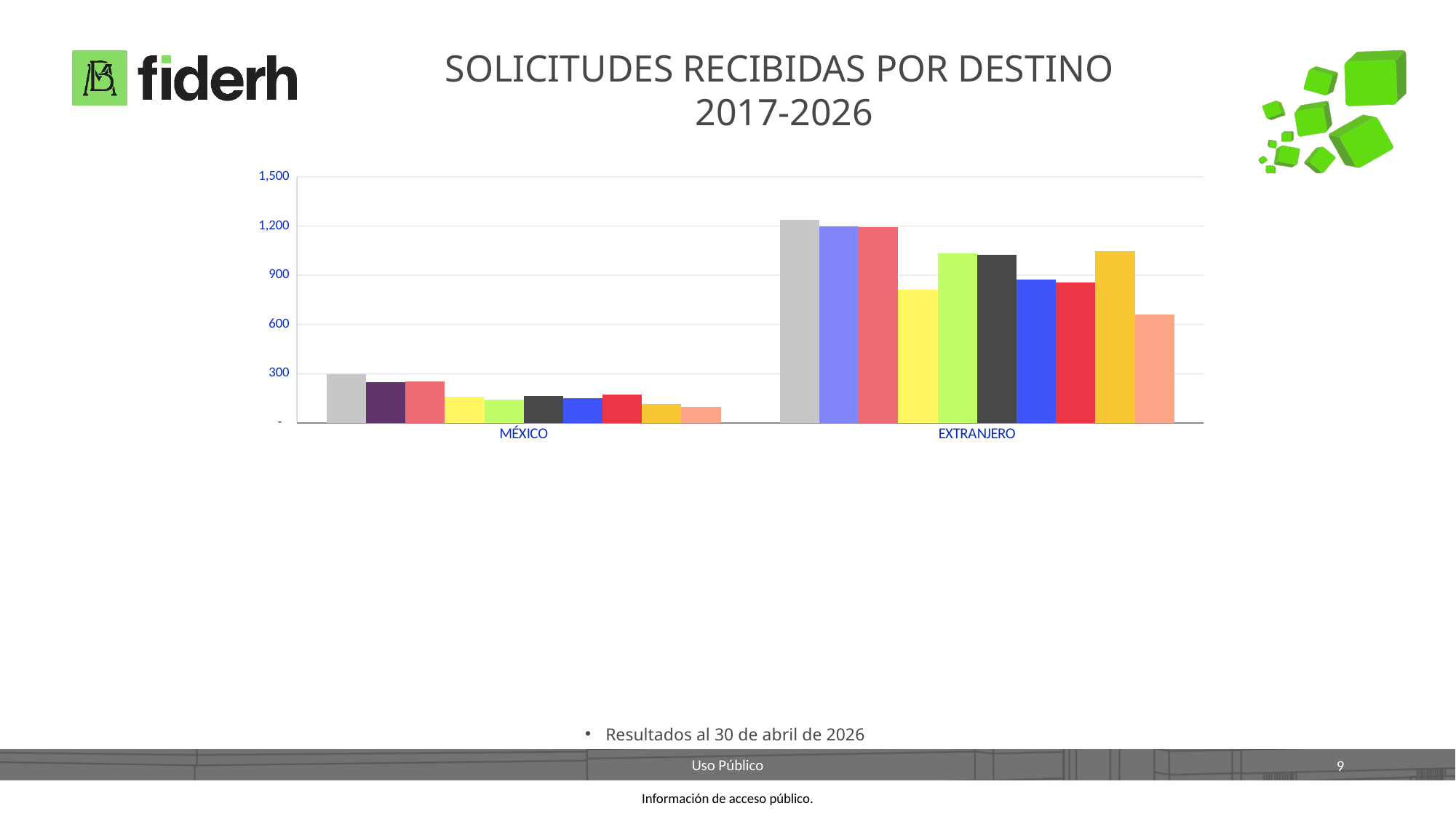
What kind of chart is shown on the slide? bar chart What is the highest value labelled on the vertical axis of the chart? 1,500 Is the value of the tallest bar in the EXTRANJERO group greater or less than 900? greater Is the value of the last (rightmost) bar in the EXTRANJERO group greater or less than 900? less Which category has the taller bars overall, MÉXICO or EXTRANJERO? EXTRANJERO What is the title of the chart on the slide? SOLICITUDES RECIBIDAS POR DESTINO 2017-2026 Is the value of the last (rightmost) bar in the EXTRANJERO group greater or less than 300? greater How many bars are plotted for the MÉXICO category? 10 How many destination categories are shown on the x axis of the chart? 2